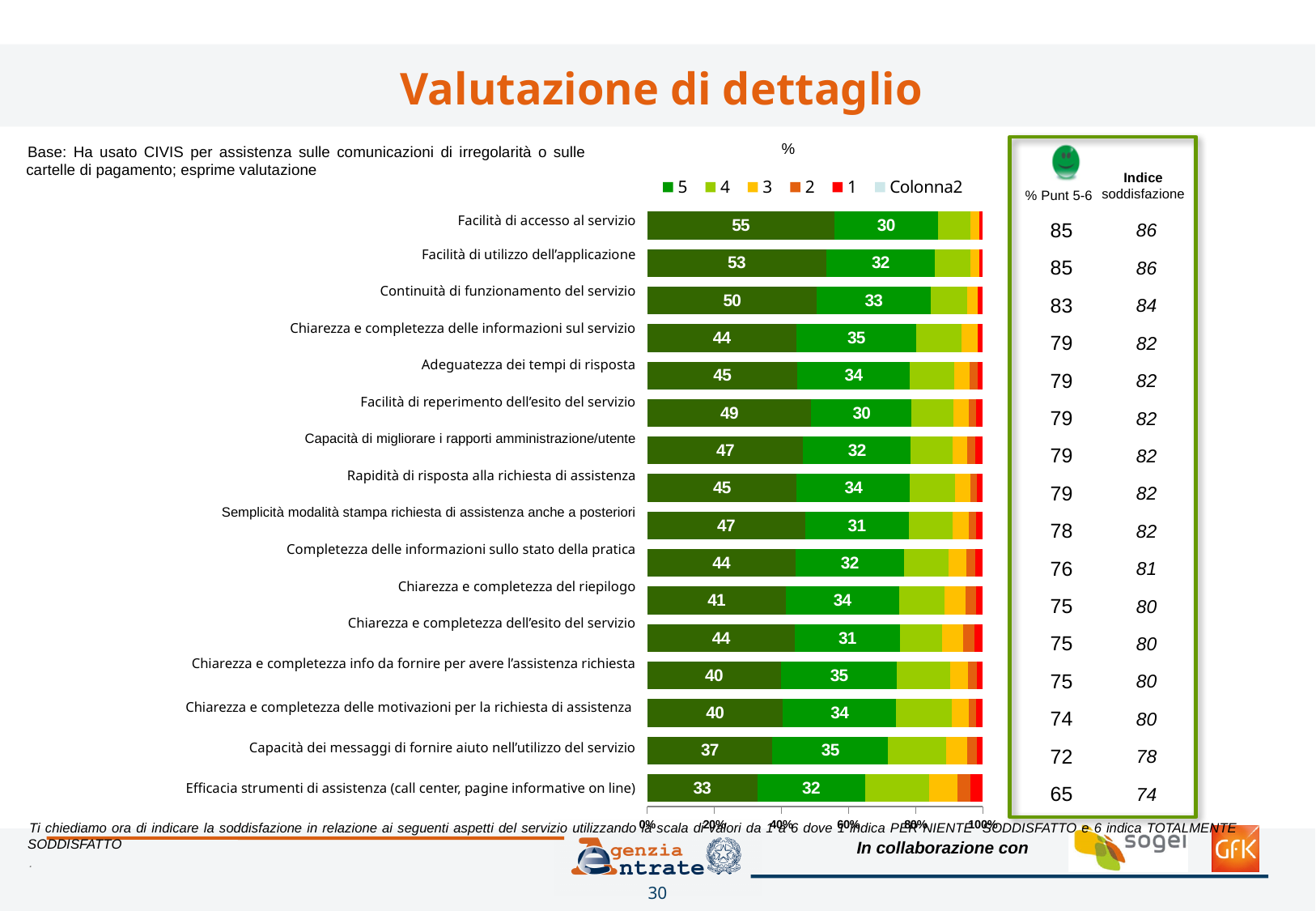
What is the difference between the series 5 values for "Facilità di accesso al servizio" and "Efficacia strumenti di assistenza (call center, pagine informative on line)"? 22 How many categories are shown in the chart? 16 Which category has the lowest value for series 5? Efficacia strumenti di assistenza (call center, pagine informative on line) What is the combined value of series 5 and series 4 for "Facilità di accesso al servizio"? 85 What is the value of series 5 for "Facilità di accesso al servizio"? 55 What is the title of the slide? Valutazione di dettaglio What kind of chart is shown on the slide? Stacked bar chart What is the value of series 4 for "Continuità di funzionamento del servizio"? 33 Which has a larger series 5 value: "Facilità di utilizzo dell'applicazione" or "Chiarezza e completezza del riepilogo"? Facilità di utilizzo dell'applicazione How many series does the legend list? 6 Which category has the highest value for series 5? Facilità di accesso al servizio What is the value of series 4 for "Efficacia strumenti di assistenza (call center, pagine informative on line)"? 32